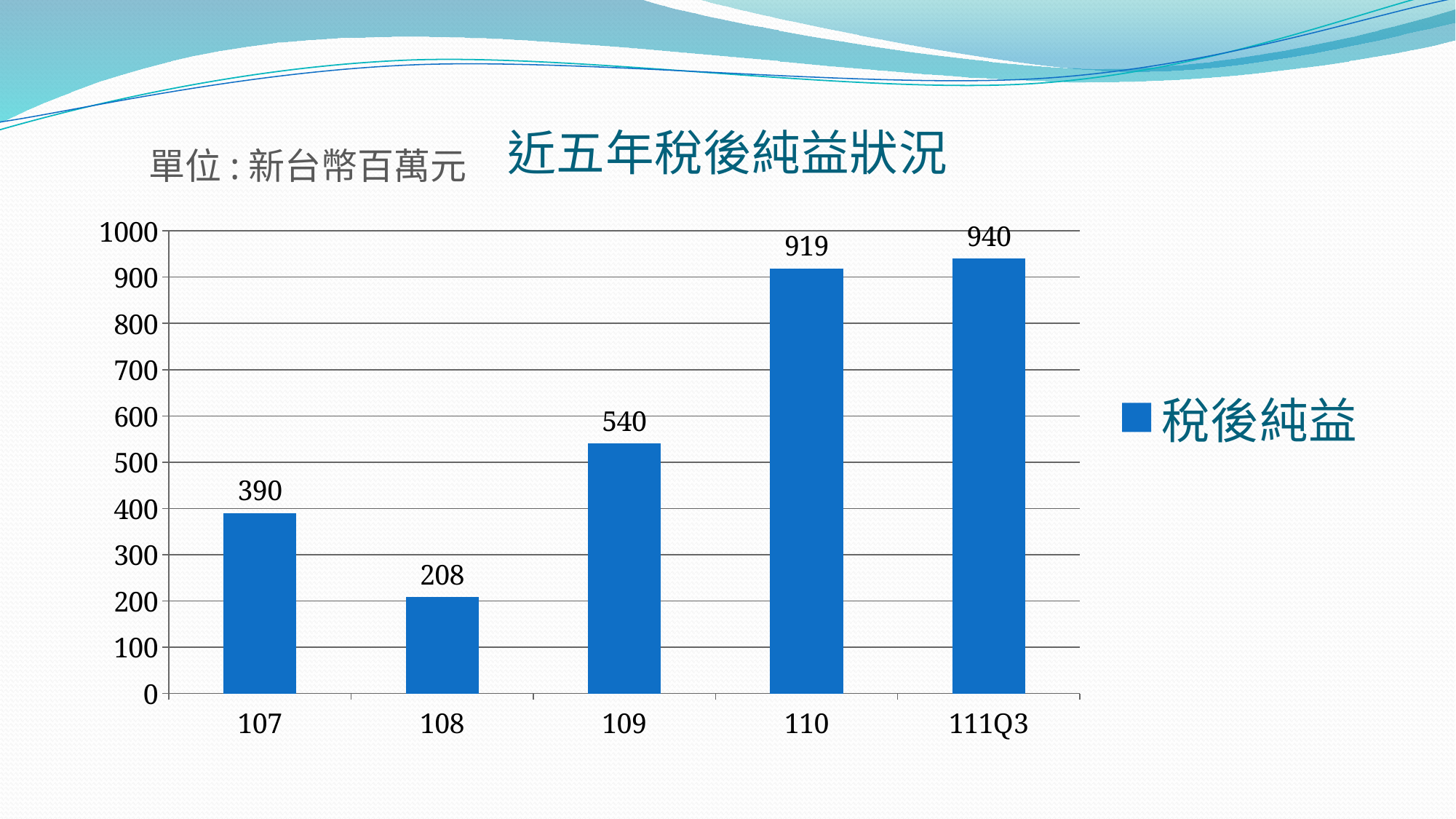
Which category has the highest value? 111Q3 What is the value for 110? 919 What is the value for 109? 540 How many categories are shown on the x axis? 5 What is the value for 111Q3? 940 Which category has the lowest value? 108 What kind of chart is this? bar chart What is the value for 107? 390 Which is larger, the value for 107 or the value for 109? 109 What is the value for 108? 208 What is the difference between the values for 110 and 109? 379 What is the title of the chart? 近五年稅後純益狀況